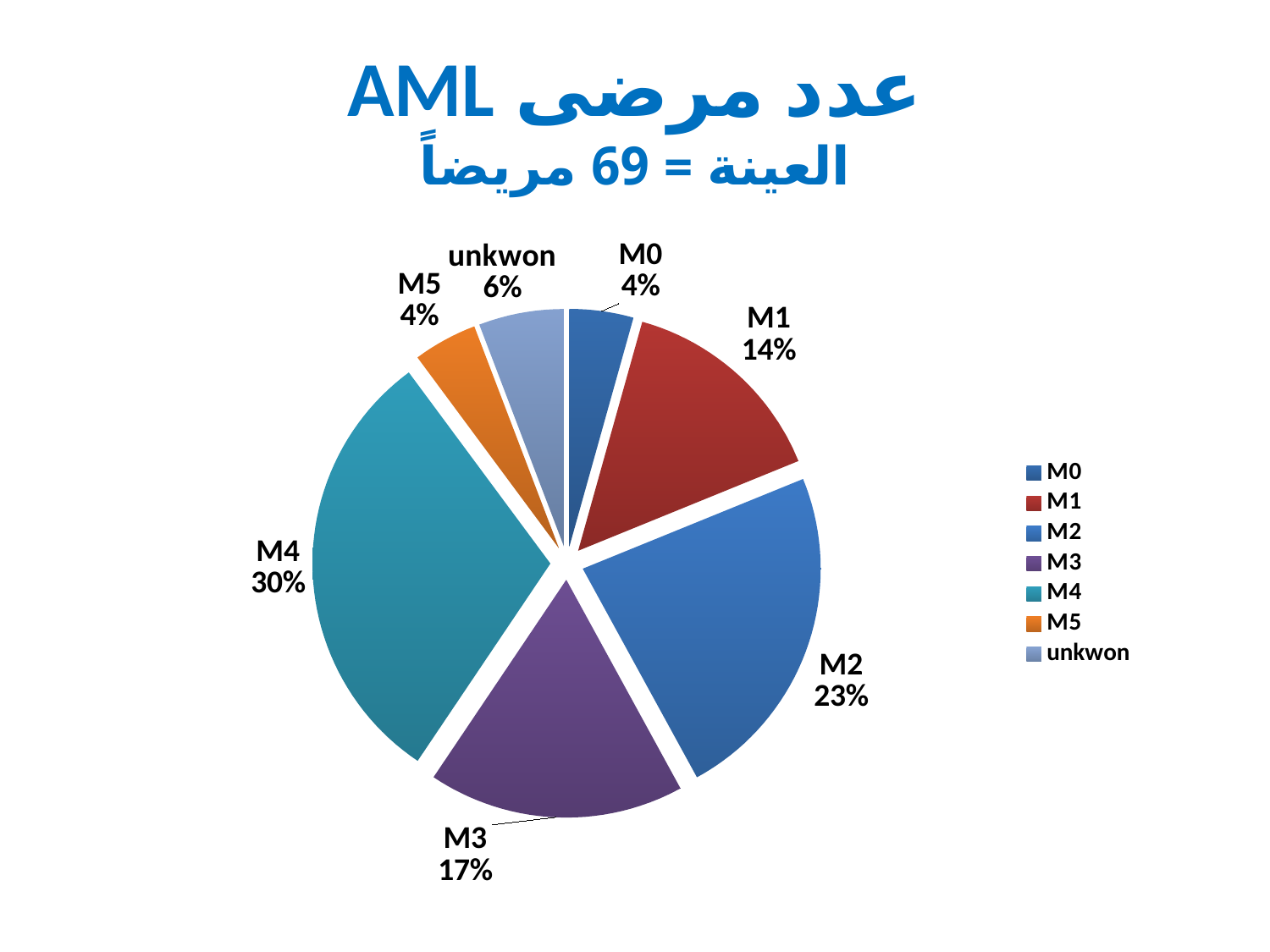
What percentage of AML patients are classified as M2? 23% What percentage of AML patients are classified as unkwon? 6% What percentage of AML patients are classified as M4? 30% How many entries does the legend list? 7 What colour is the M4 slice in the pie chart? teal What is the difference in percentage points between M3 and M1? 3 What percentage of AML patients are classified as M1? 14% What is the difference in percentage points between M4 and M2? 7 Which category has the largest share of the pie? M4 What type of chart is shown on the slide? pie chart Which is larger, the share for M3 or the share for M1? M3 How many categories does the pie chart show? 7